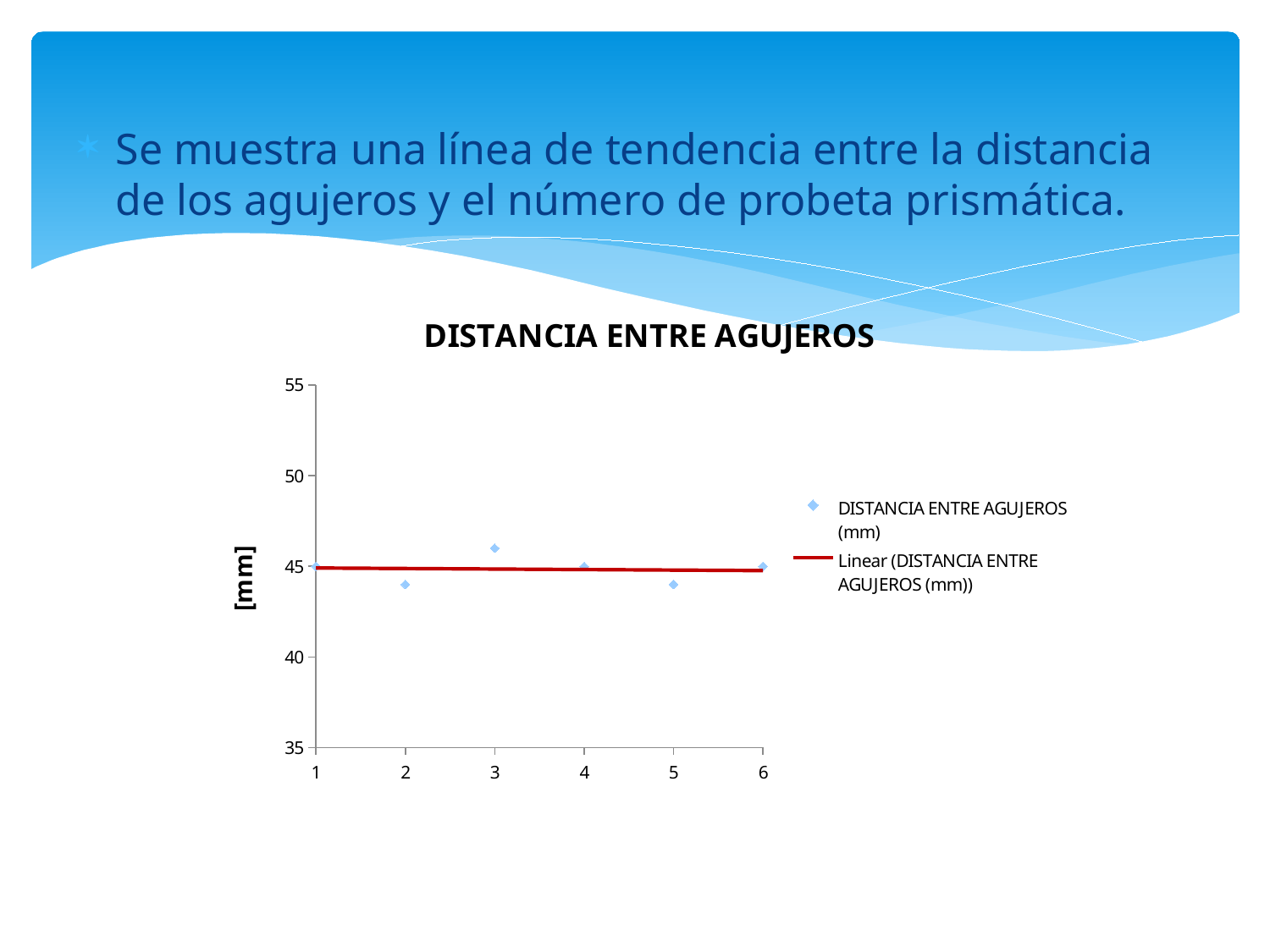
What is the label on the vertical axis of the chart? [mm] How many entries does the chart legend list? 2 Is the value at x = 1 greater or less than 40? greater At which x value is the plotted distance highest? 3 Does the linear trendline rise, fall, or stay roughly flat across the x axis? roughly flat Which has the larger value, the point at x = 3 or the point at x = 2? x = 3 What is the title of the chart? DISTANCIA ENTRE AGUJEROS Is the value at x = 5 greater or less than 50? less Is the value at x = 3 greater or less than 45? greater How many data points are plotted in the chart? 6 What kind of chart is shown on the slide? scatter chart